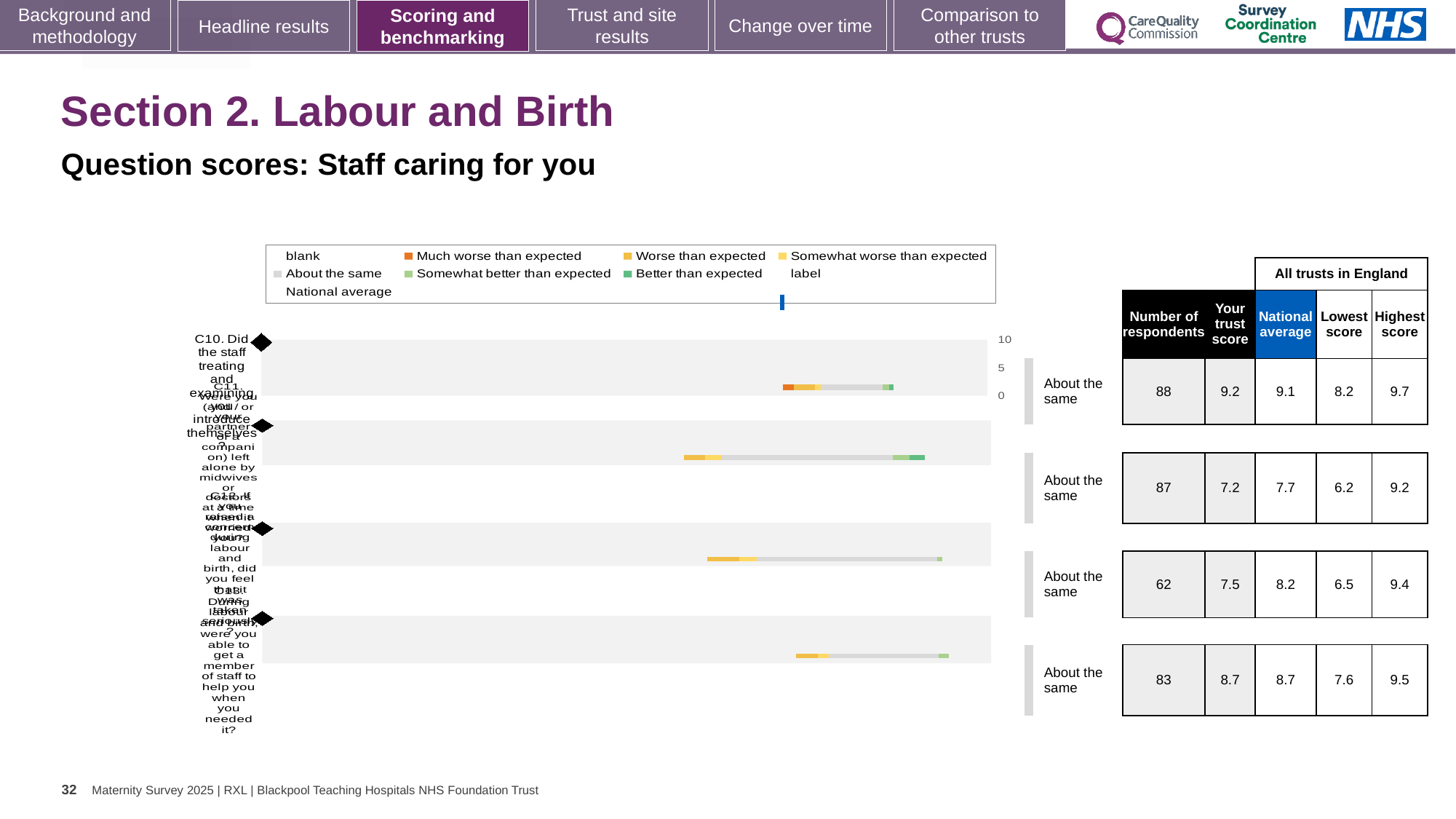
What is the highest score across all trusts in England for the fourth question row? 9.5 What is the difference between the national average and the trust score for the third question row? 0.7 What is the national average for the second question row in the table? 7.7 What kind of chart is used to show the question scores? Bar chart What benchmark category is shown for every question row on this slide? About the same What is the lowest score across all trusts in England for the third question row? 6.5 For the second question row, is the trust score higher or lower than the national average? Lower Which question row has the fewest respondents? The third row (62 respondents) Which question row has the highest trust score? The first row (C10), 9.2 What is the trust's score for the first question row (C10)? 9.2 What is the number of respondents for the first question row (C10) in the table? 88 How many question rows are plotted in the chart? 4